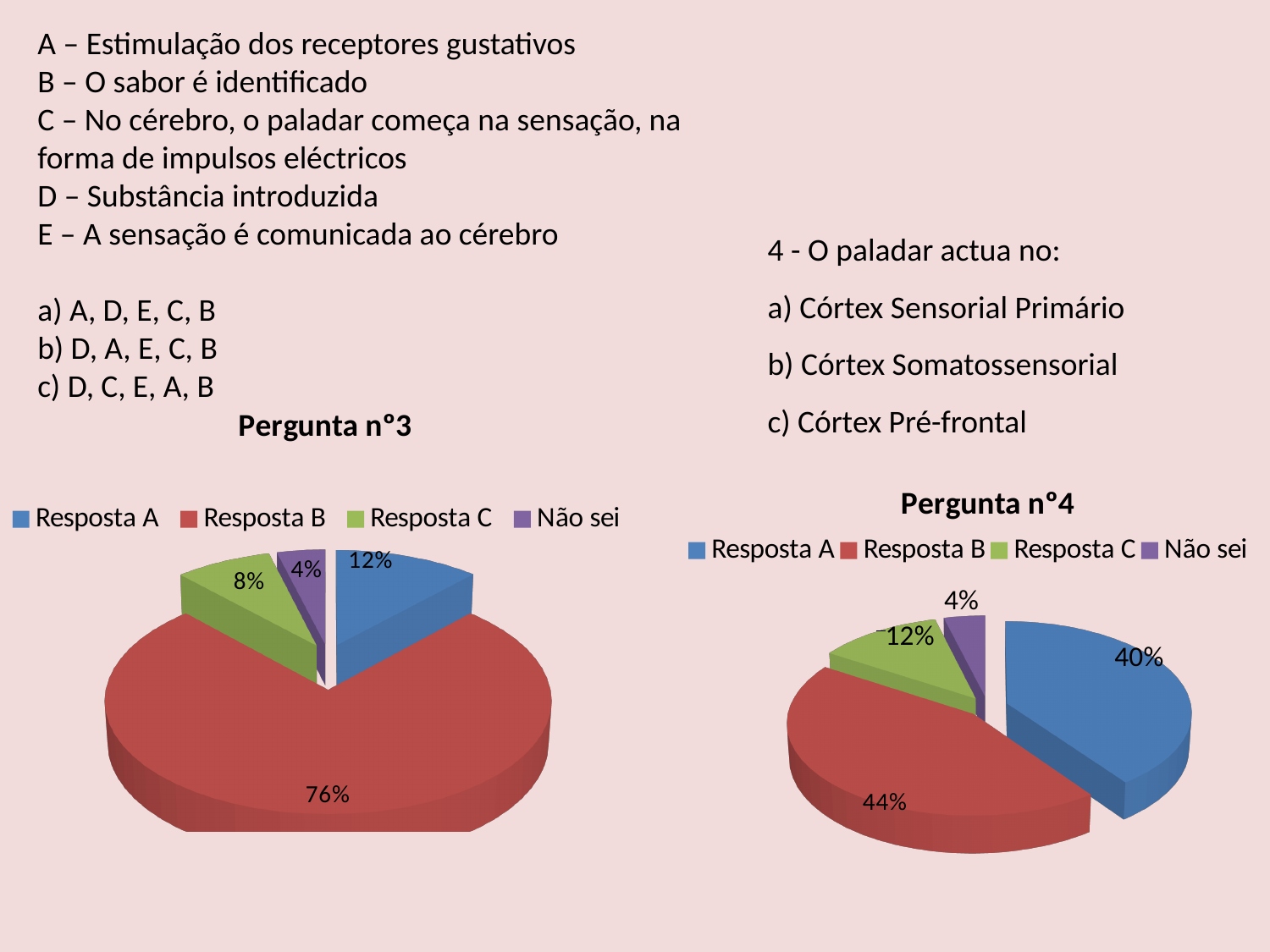
In the "Pergunta nº4" chart, what percentage is shown for Resposta A? 40% In the "Pergunta nº3" chart, what percentage is shown for Resposta A? 12% In the "Pergunta nº4" chart, which response has the largest share? Resposta B What type of chart is the "Pergunta nº4" chart? Pie chart In the "Pergunta nº3" chart, which response has the largest share? Resposta B In the "Pergunta nº4" chart, what percentage is shown for Resposta C? 12% How many entries does the legend of the "Pergunta nº3" chart list? 4 In the "Pergunta nº3" chart, what percentage is shown for Resposta B? 76% In the "Pergunta nº4" chart, what is the difference between the shares of Resposta B and Resposta A? 4% In the "Pergunta nº3" chart, which response has the smallest share? Não sei In the "Pergunta nº3" chart, what is the difference between the shares of Resposta A and Resposta C? 4% In the "Pergunta nº4" chart, which is larger, the share for Resposta C or the share for Não sei? Resposta C